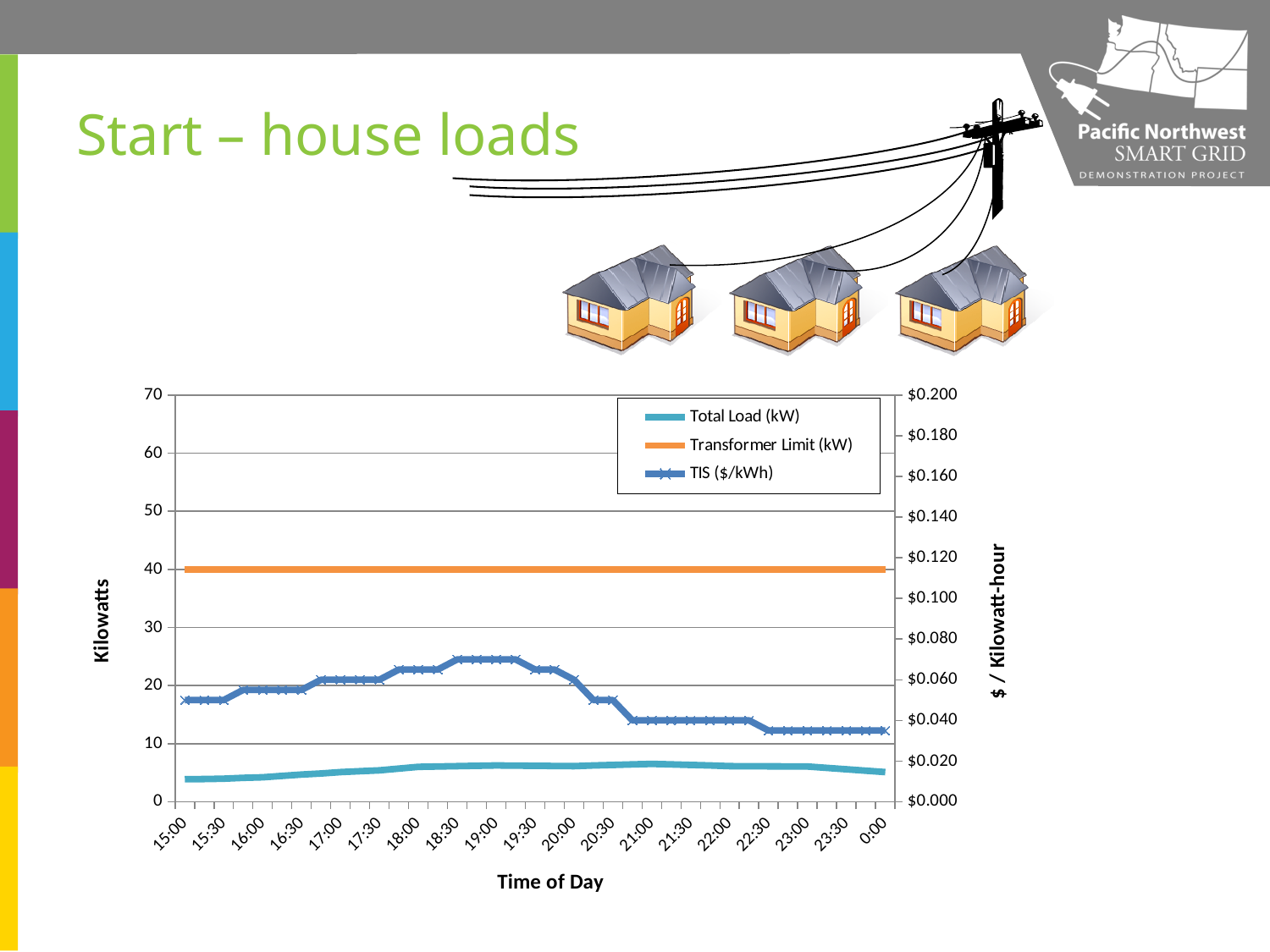
Is the TIS ($/kWh) value at 15:00 greater or less than $0.040? greater Is the Total Load (kW) value at 19:00 greater or less than 10? less Does the TIS ($/kWh) series rise or fall between 20:00 and 21:00? fall How many time labels are shown on the x axis of the chart? 19 How many series does the chart legend list? 3 What is the title of the left vertical axis of the chart? Kilowatts What is the title of the x axis of the chart? Time of Day Which is larger at 20:00, the Transformer Limit (kW) or the Total Load (kW)? Transformer Limit (kW) Is the TIS ($/kWh) value at 19:00 greater or less than $0.060? greater What is the value of the Transformer Limit (kW) series on the chart? 40 What kind of chart is shown on the slide? line chart